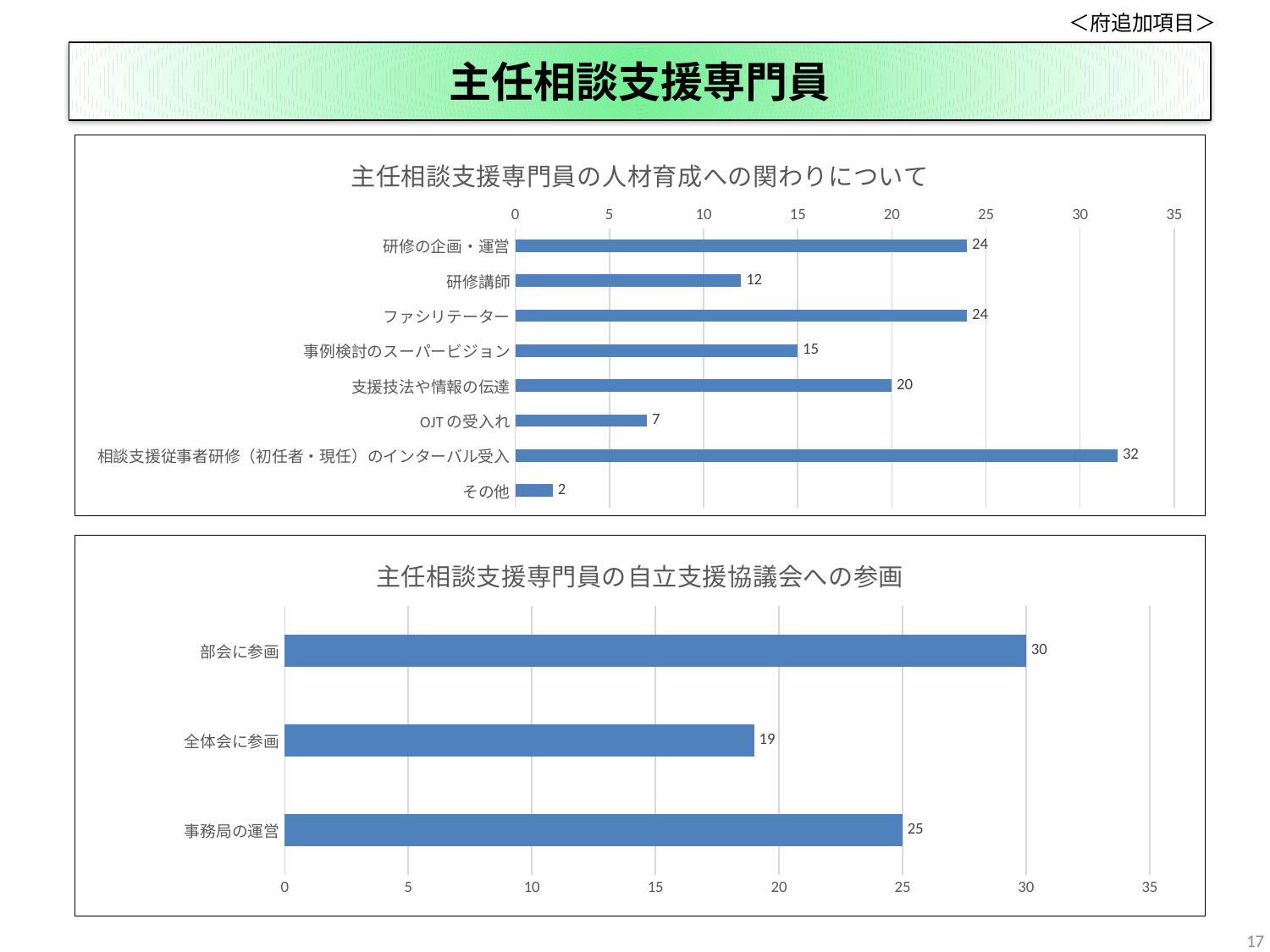
In the top chart titled 主任相談支援専門員の人材育成への関わりについて, which category has the highest value? 相談支援従事者研修（初任者・現任）のインターバル受入 In the top chart titled 主任相談支援専門員の人材育成への関わりについて, what is the value for 研修講師? 12 In the bottom chart titled 主任相談支援専門員の自立支援協議会への参画, what is the value for 全体会に参画? 19 In the top chart titled 主任相談支援専門員の人材育成への関わりについて, what is the difference between the values for 支援技法や情報の伝達 and OJTの受入れ? 13 In the top chart titled 主任相談支援専門員の人材育成への関わりについて, what is the value for ファシリテーター? 24 In the top chart titled 主任相談支援専門員の人材育成への関わりについて, how many categories are shown? 8 In the top chart titled 主任相談支援専門員の人材育成への関わりについて, which is larger: 事例検討のスーパービジョン or 研修講師? 事例検討のスーパービジョン In the bottom chart titled 主任相談支援専門員の自立支援協議会への参画, which category has the highest value? 部会に参画 In the bottom chart titled 主任相談支援専門員の自立支援協議会への参画, how many categories are shown? 3 In the top chart titled 主任相談支援専門員の人材育成への関わりについて, which category has the lowest value? その他 In the bottom chart titled 主任相談支援専門員の自立支援協議会への参画, what is the difference between the values for 部会に参画 and 事務局の運営? 5 What kind of chart is the bottom chart titled 主任相談支援専門員の自立支援協議会への参画? Bar chart